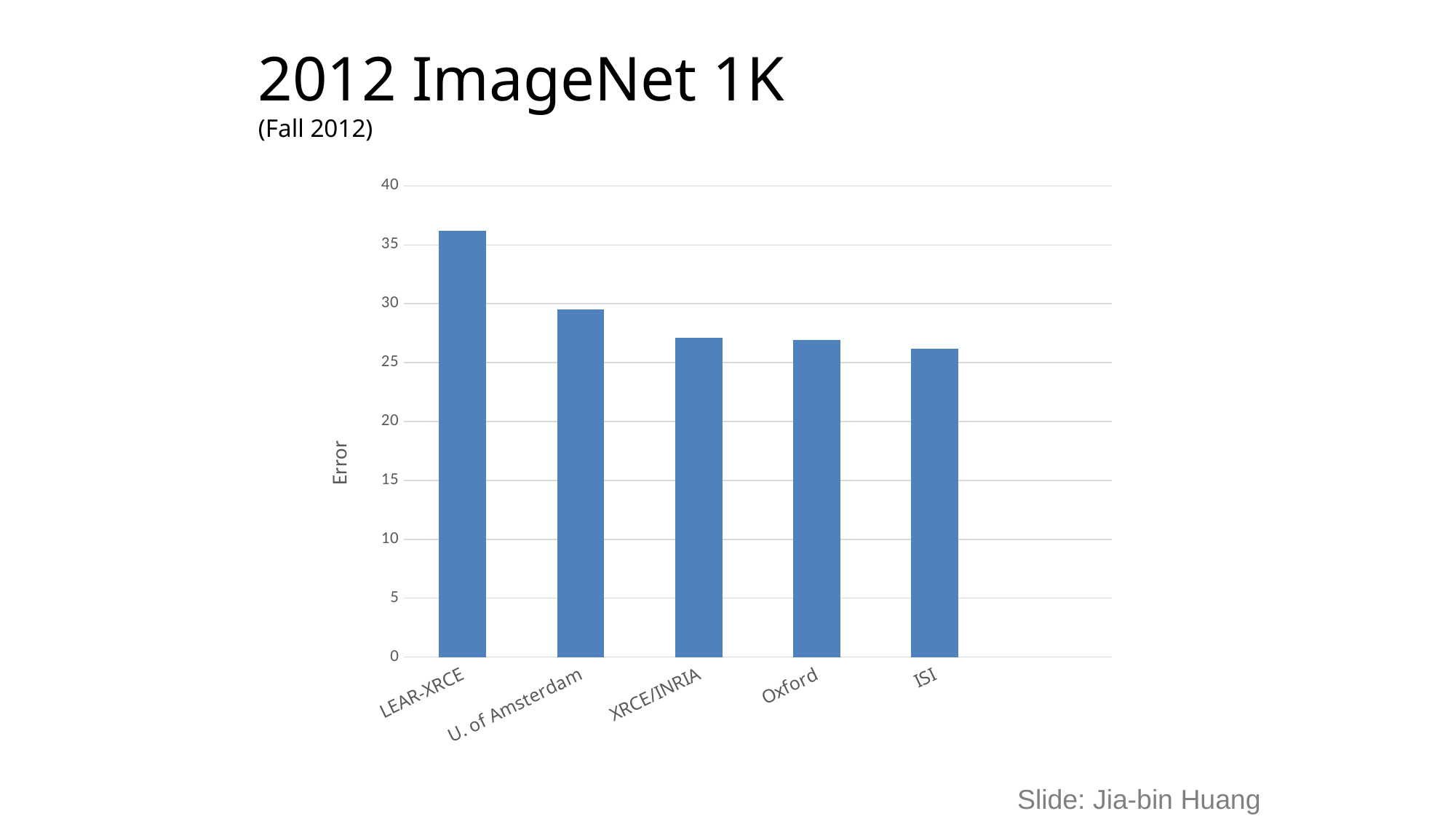
Which has a higher error, U. of Amsterdam or Oxford? U. of Amsterdam Is the error for Oxford greater or less than 30? less How many teams (categories) are plotted in the chart? 5 What is the label on the vertical axis of the chart? Error Is the error for LEAR-XRCE greater or less than 35? greater Is the error for XRCE/INRIA greater or less than 30? less Which has a higher error, LEAR-XRCE or ISI? LEAR-XRCE What kind of chart is shown on the slide? bar chart Which team has the highest error in the chart? LEAR-XRCE Do the error values rise or fall moving from left to right across the teams? fall